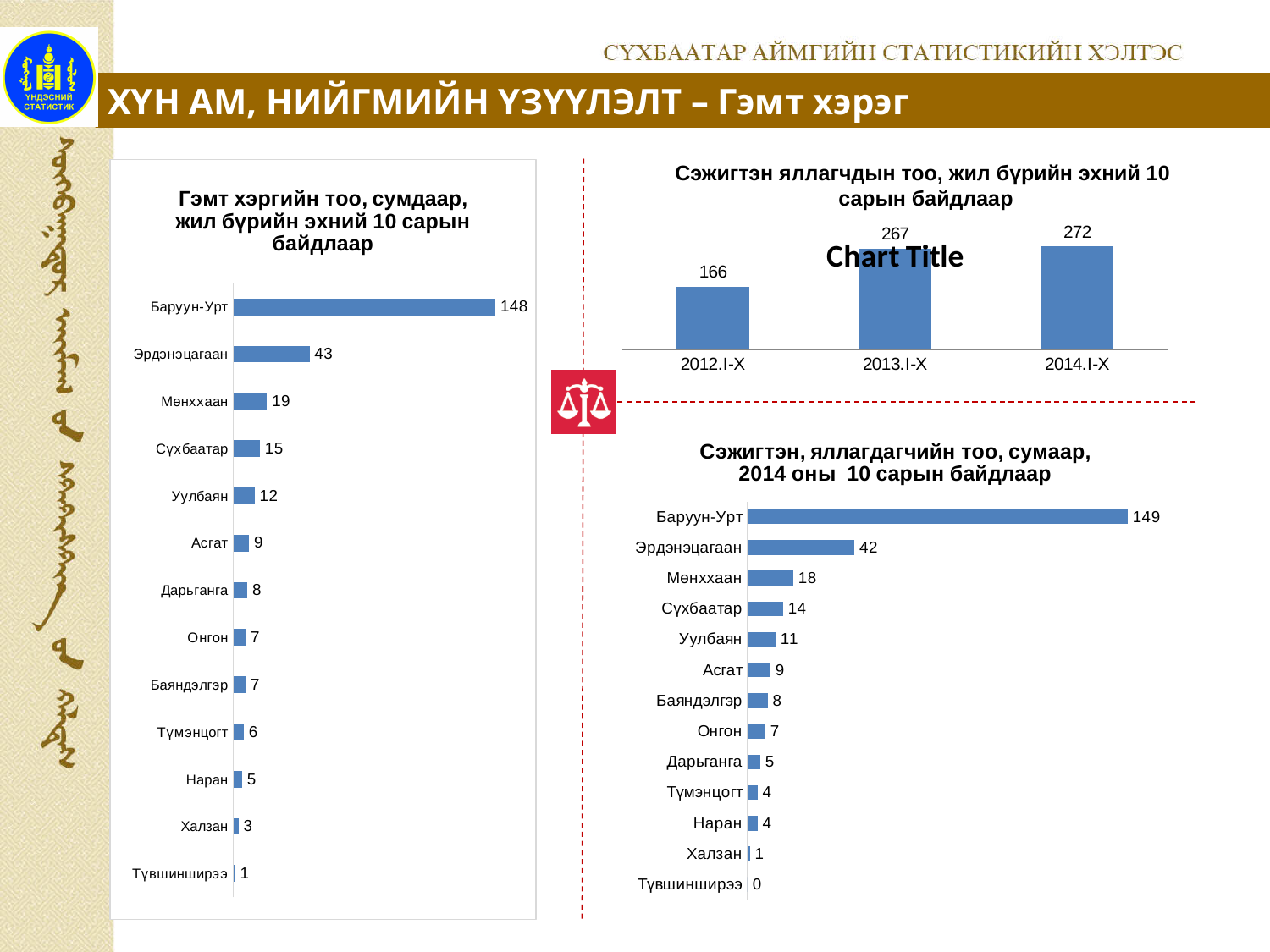
In the bottom right chart 'Сэжигтэн, яллагдагчийн тоо, сумаар', what is the value for Мөнххаан? 18 In the bottom right chart 'Сэжигтэн, яллагдагчийн тоо, сумаар', what is the value for Түвшинширээ? 0 In the left chart 'Гэмт хэргийн тоо, сумдаар', which category has the lowest value? Түвшинширээ In the left chart 'Гэмт хэргийн тоо, сумдаар', how many categories are shown? 13 In the left chart 'Гэмт хэргийн тоо, сумдаар', what is the value for Баруун-Урт? 148 In the top right chart 'Сэжигтэн яллагчдын тоо', do the values rise or fall from 2012.I-X to 2014.I-X? rise What kind of chart is the top right chart 'Сэжигтэн яллагчдын тоо'? bar chart In the top right chart 'Сэжигтэн яллагчдын тоо', what is the difference between 2013.I-X and 2012.I-X? 101 In the top right chart 'Сэжигтэн яллагчдын тоо', what is the value for 2013.I-X? 267 In the left chart 'Гэмт хэргийн тоо, сумдаар', what is the difference between Баруун-Урт and Эрдэнэцагаан? 105 In the top right chart 'Сэжигтэн яллагчдын тоо', which year has the highest value? 2014.I-X In the bottom right chart 'Сэжигтэн, яллагдагчийн тоо, сумаар', which is larger, Сүхбаатар or Уулбаян? Сүхбаатар